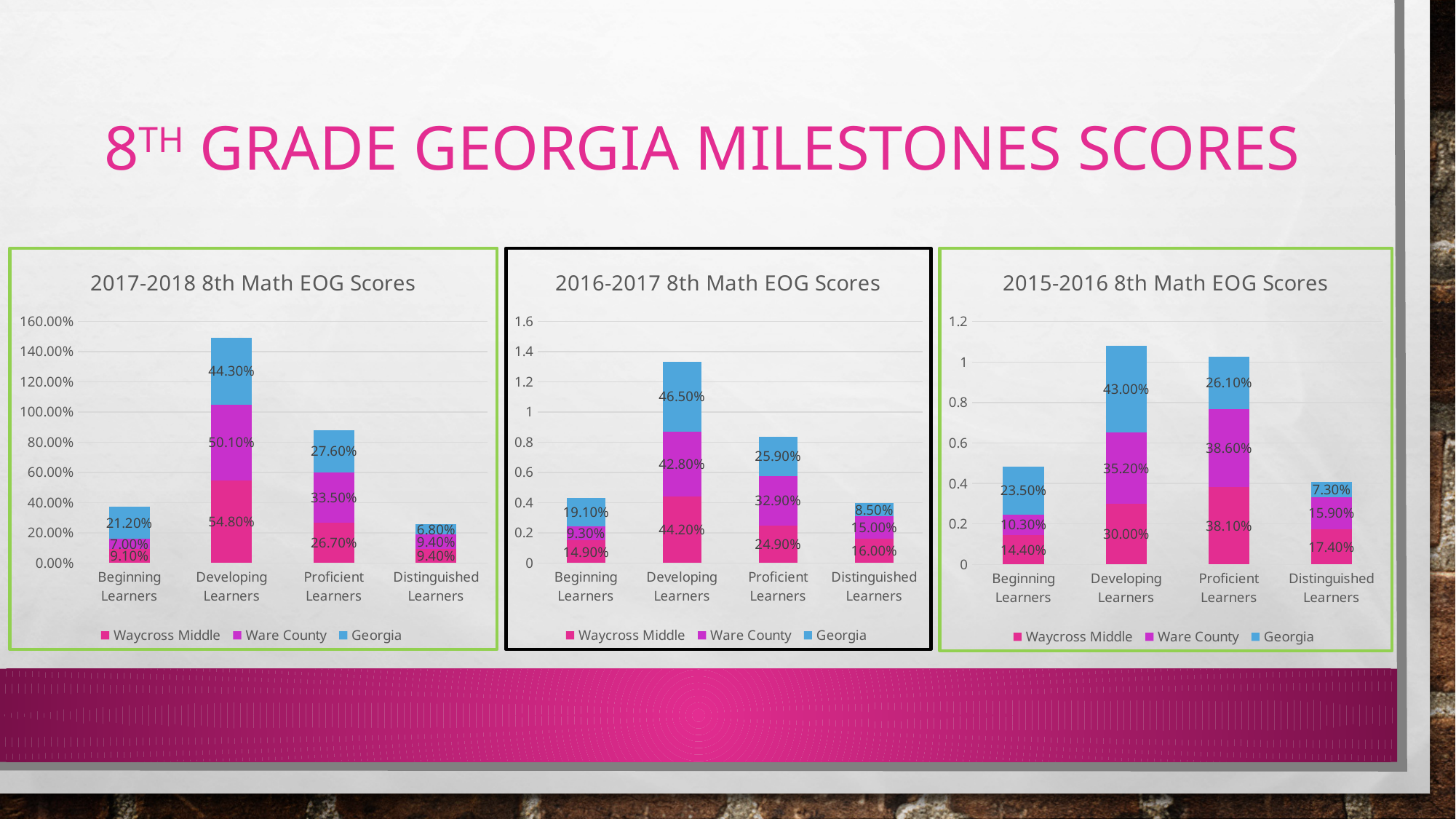
In the 2017-2018 8th Math EOG Scores chart, what is the difference between the Waycross Middle and Georgia values for Developing Learners? 10.50% In the 2015-2016 8th Math EOG Scores chart, which is larger for Developing Learners: the Waycross Middle value or the Georgia value? Georgia In the 2016-2017 8th Math EOG Scores chart, what is the value for Georgia in the Beginning Learners category? 19.10% In the 2015-2016 8th Math EOG Scores chart, what is the total of the stacked bar for Proficient Learners? 102.80% How many categories are shown on the x axis of the 2017-2018 8th Math EOG Scores chart? 4 In the 2016-2017 8th Math EOG Scores chart, what is the total of the stacked bar for Developing Learners? 133.50% In the 2017-2018 8th Math EOG Scores chart, what is the value for Waycross Middle in the Developing Learners category? 54.80% What kind of chart is the 2015-2016 8th Math EOG Scores chart? Stacked bar chart How many series does the legend of the 2016-2017 8th Math EOG Scores chart list? 3 In the 2016-2017 8th Math EOG Scores chart, which category has the shortest stacked bar? Distinguished Learners In the 2015-2016 8th Math EOG Scores chart, what is the value for Ware County in the Proficient Learners category? 38.60% In the 2017-2018 8th Math EOG Scores chart, which category has the tallest stacked bar? Developing Learners